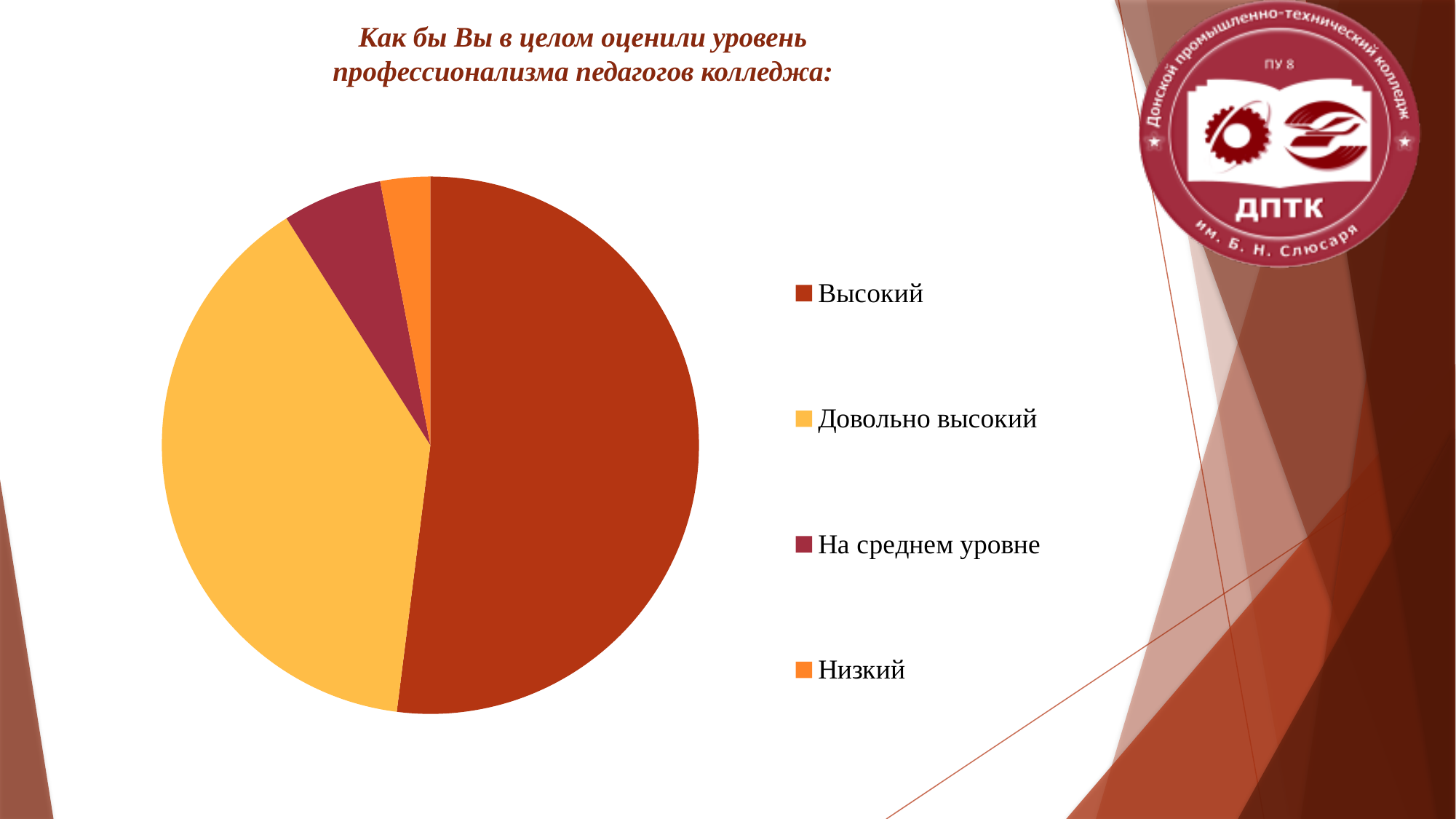
Which category has the second-largest slice of the pie chart? Довольно высокий Which slice is larger: Высокий or Довольно высокий? Высокий How many categories (slices) does the pie chart have? 4 Which slice is larger: Довольно высокий or На среднем уровне? Довольно высокий Which category has the largest slice of the pie chart? Высокий What kind of chart is shown on the slide? pie chart Which category has the smallest slice of the pie chart? Низкий What colour is the slice for Довольно высокий? yellow What is the title of the chart? Как бы Вы в целом оценили уровень профессионализма педагогов колледжа: